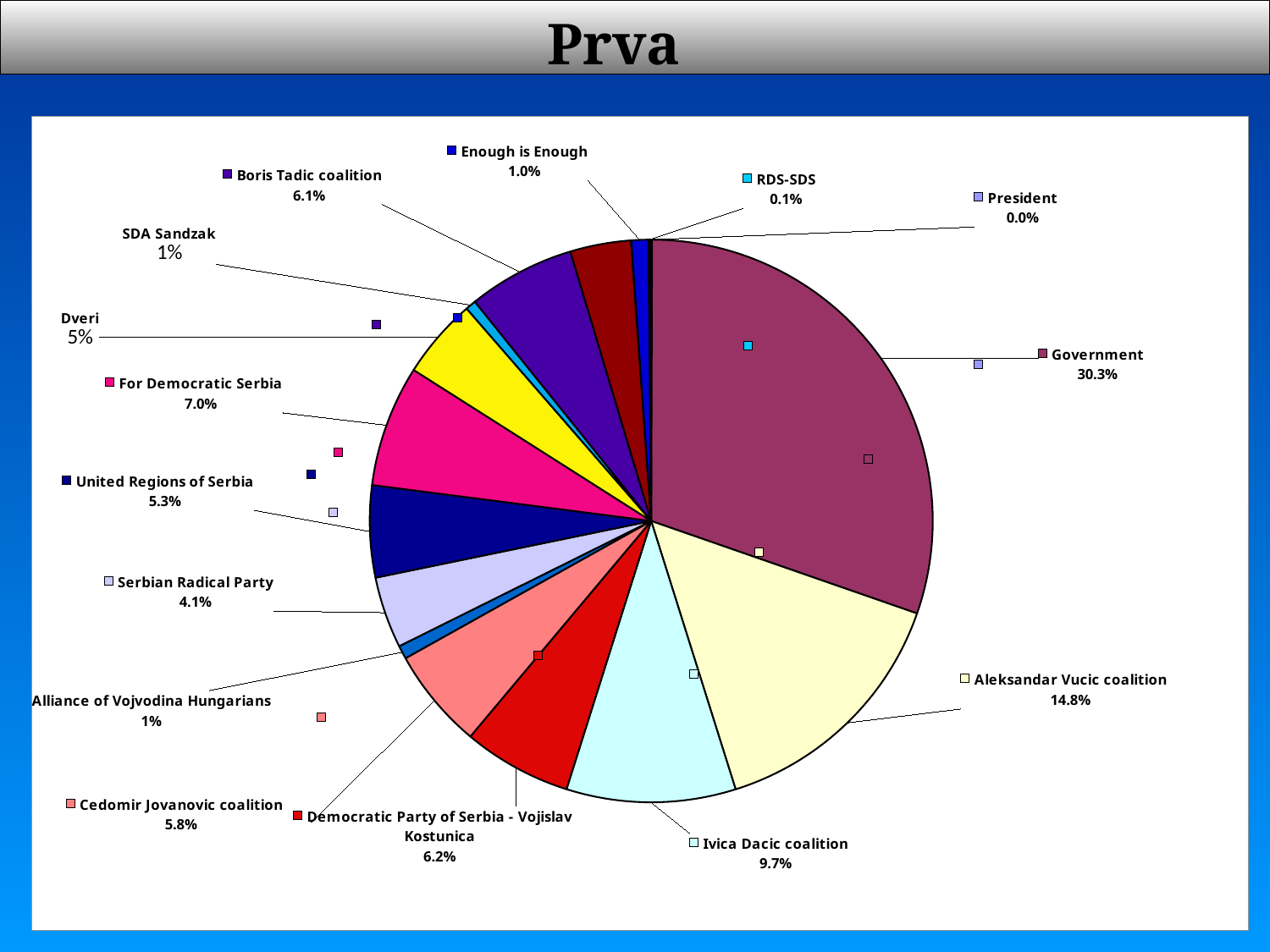
What is the value for Democratic Party of Serbia - Vojislav Kostunica? 6.2% What is the value for Serbian Radical Party? 4.1% Which is larger, For Democratic Serbia or Boris Tadic coalition? For Democratic Serbia What type of chart is shown on the slide? pie chart Which category has the largest slice? Government What is the title of the slide? Prva What is the value for Aleksandar Vucic coalition? 14.8% What is the value for Ivica Dacic coalition? 9.7% What is the value for Government? 30.3% Which category has the smallest value? President What is the difference between the values for Government and Aleksandar Vucic coalition? 15.5%